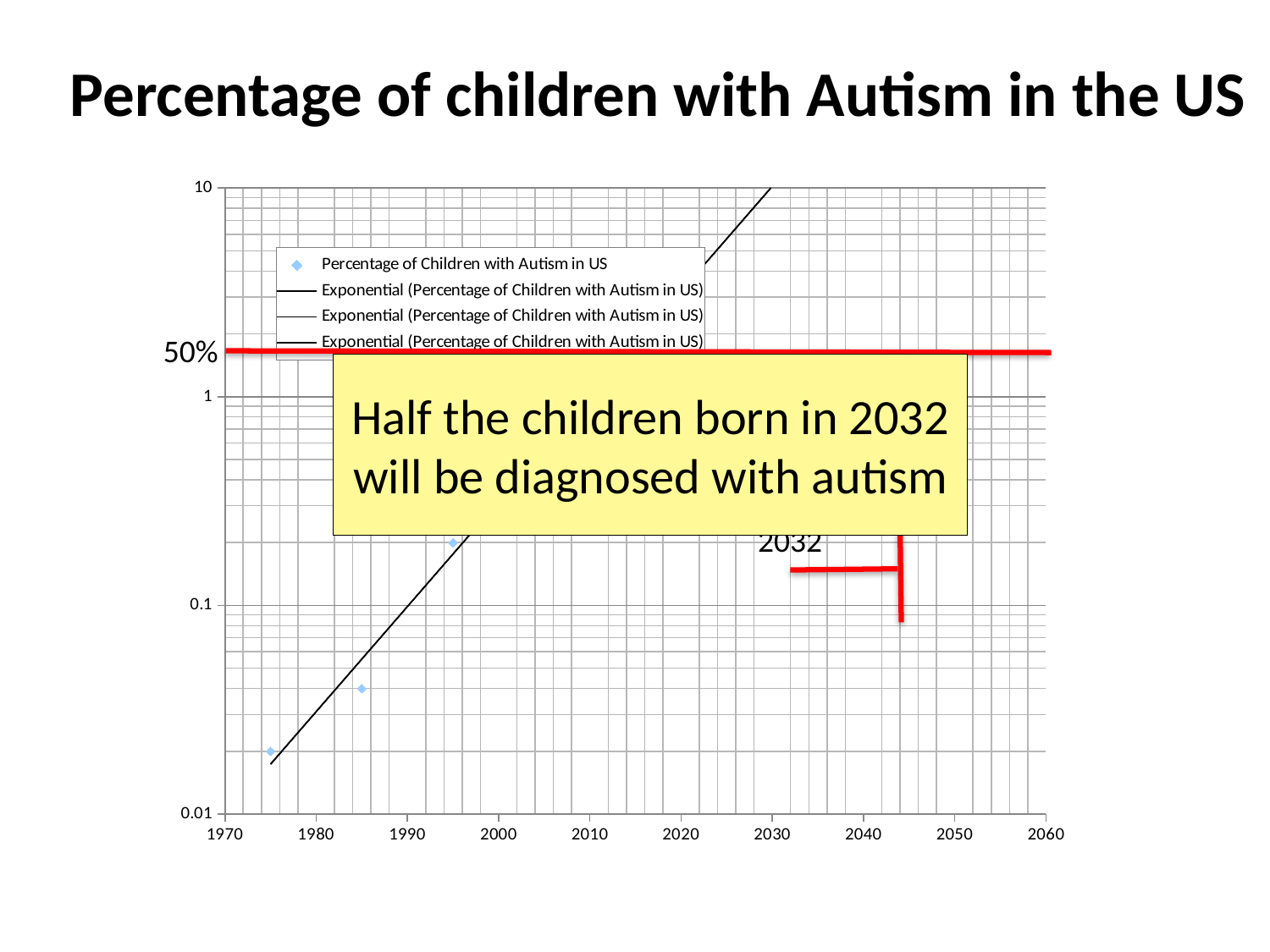
Is the value for the 1975 data point greater or less than 0.1? less How many entries does the chart's legend list? 4 According to the annotation, in what year does the trendline reach 50%? 2032 Do the plotted values rise or fall as the year increases along the x axis? rise Which of the visible data points has the lowest value? 1975 What is the highest value labelled on the y axis? 10 What kind of chart is shown on the slide? scatter chart Is the value for the 1995 data point greater or less than 0.1? greater Is the value for the 1985 data point greater or less than 0.1? less Which data point has the higher value, 1975 or 1995? 1995 What is the title of the slide's chart? Percentage of children with Autism in the US